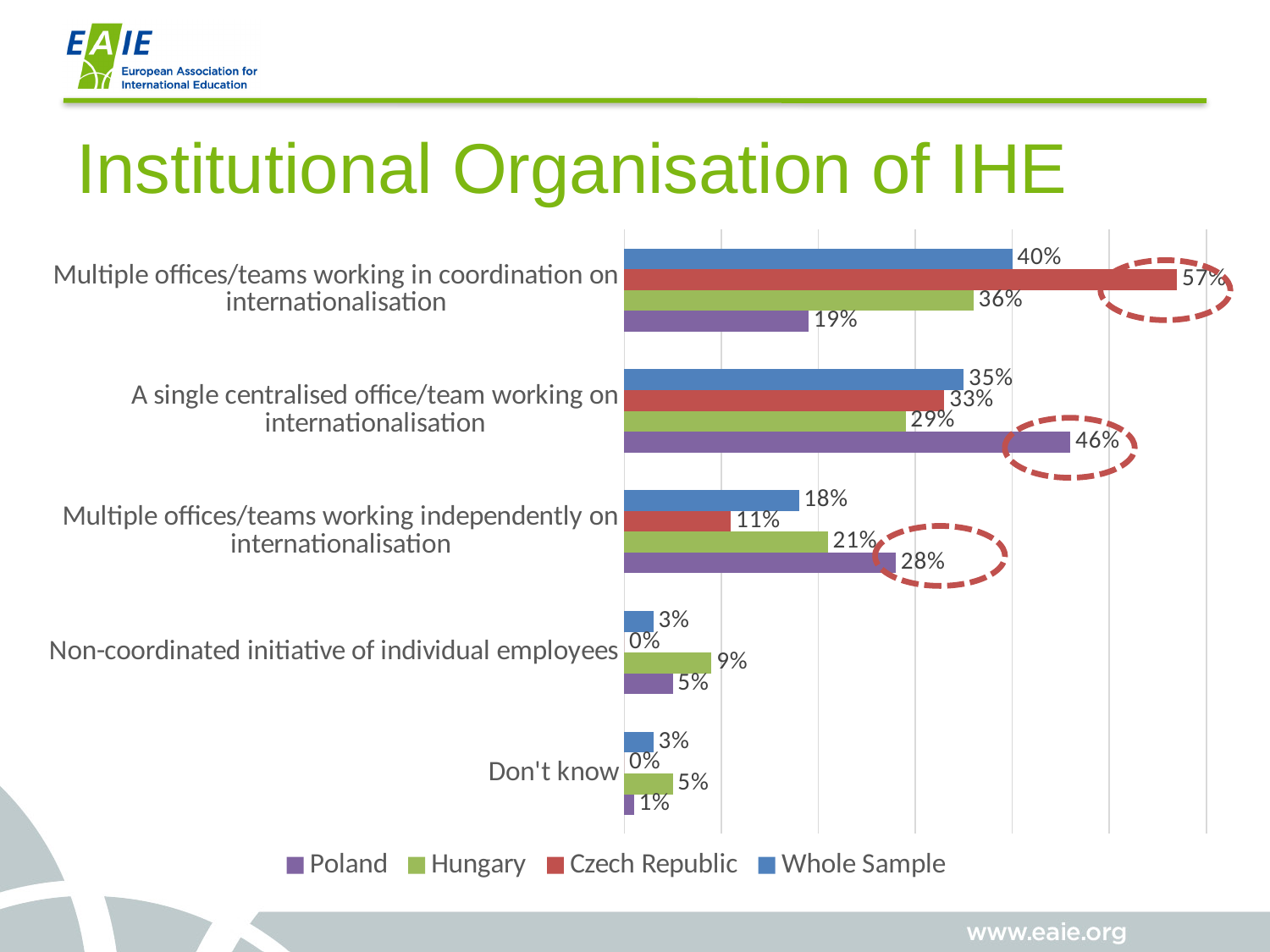
What is the Poland value for 'A single centralised office/team working on internationalisation'? 46% How many categories are shown on the chart? 5 What is the Whole Sample value for 'Multiple offices/teams working independently on internationalisation'? 18% What is the Czech Republic value for 'Multiple offices/teams working in coordination on internationalisation'? 57% What kind of chart is shown on the slide? Bar chart Which series has the highest value for 'Multiple offices/teams working in coordination on internationalisation'? Czech Republic Which series has the lowest value for 'Don't know'? Czech Republic What is the Hungary value for 'Non-coordinated initiative of individual employees'? 9% For 'Multiple offices/teams working independently on internationalisation', which is larger: the Poland value or the Hungary value? Poland How many series does the legend list? 4 Which series is shown in purple in the legend? Poland What is the difference between the Czech Republic and Poland values for 'Multiple offices/teams working in coordination on internationalisation'? 38%